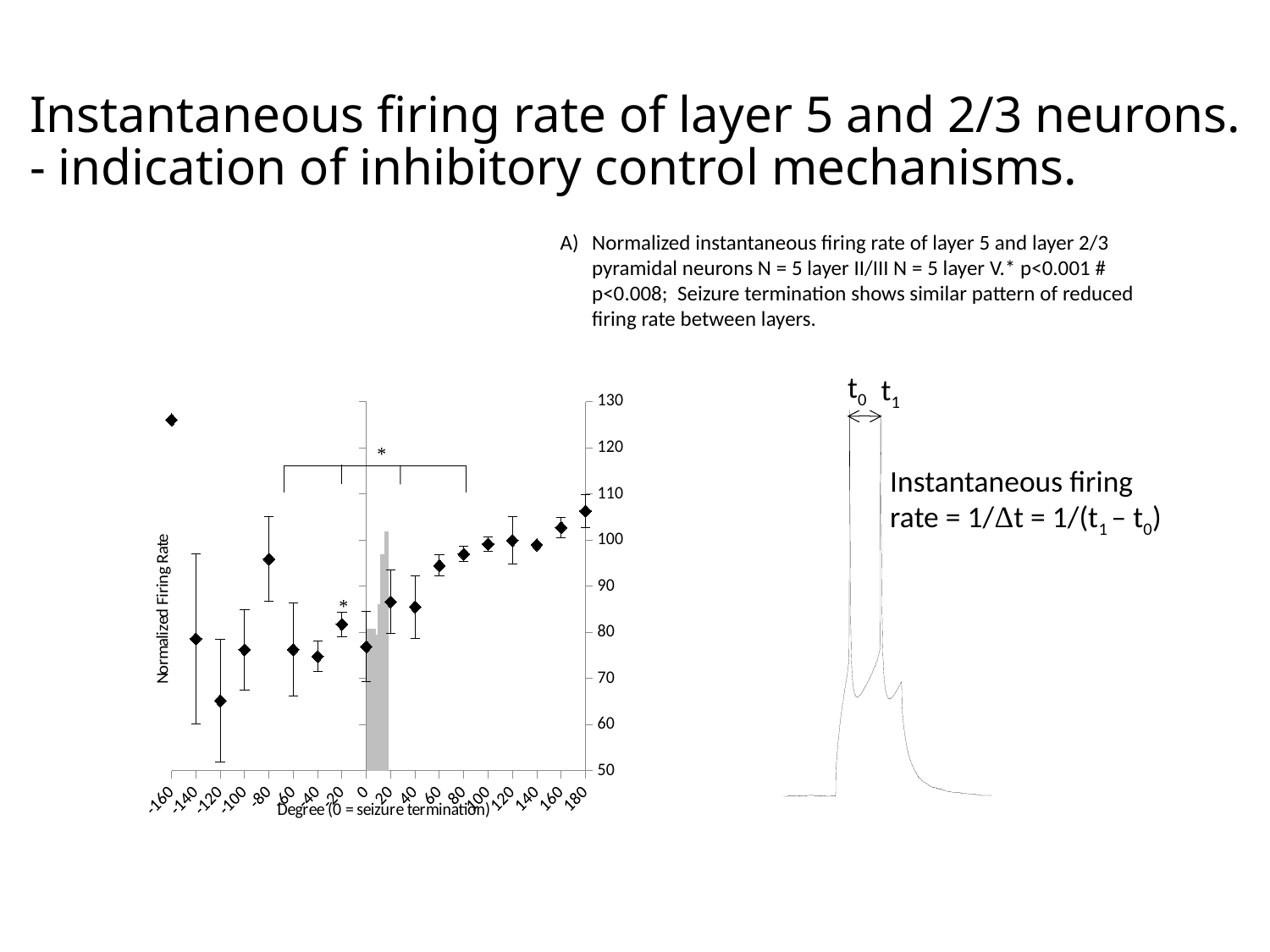
What type of chart is shown on the left of the slide? scatter chart In the left chart, is the value at 180 degrees greater or less than 100? greater In the left chart, is the value at -160 degrees greater or less than 120? greater In the left chart, is the value at -80 degrees greater or less than 90? greater In the left chart, at which degree value is the normalized firing rate highest? -160 How many data points are plotted in the left chart? 18 In the left chart, at which degree value is the normalized firing rate lowest? -120 In the left chart, do the values rise or fall from 0 degrees to 180 degrees? rise In the left chart, which has the larger normalized firing rate: 0 degrees or 180 degrees? 180 degrees In the left chart, which has the larger normalized firing rate: -80 degrees or -60 degrees? -80 degrees What is the y-axis title of the left chart? Normalized Firing Rate